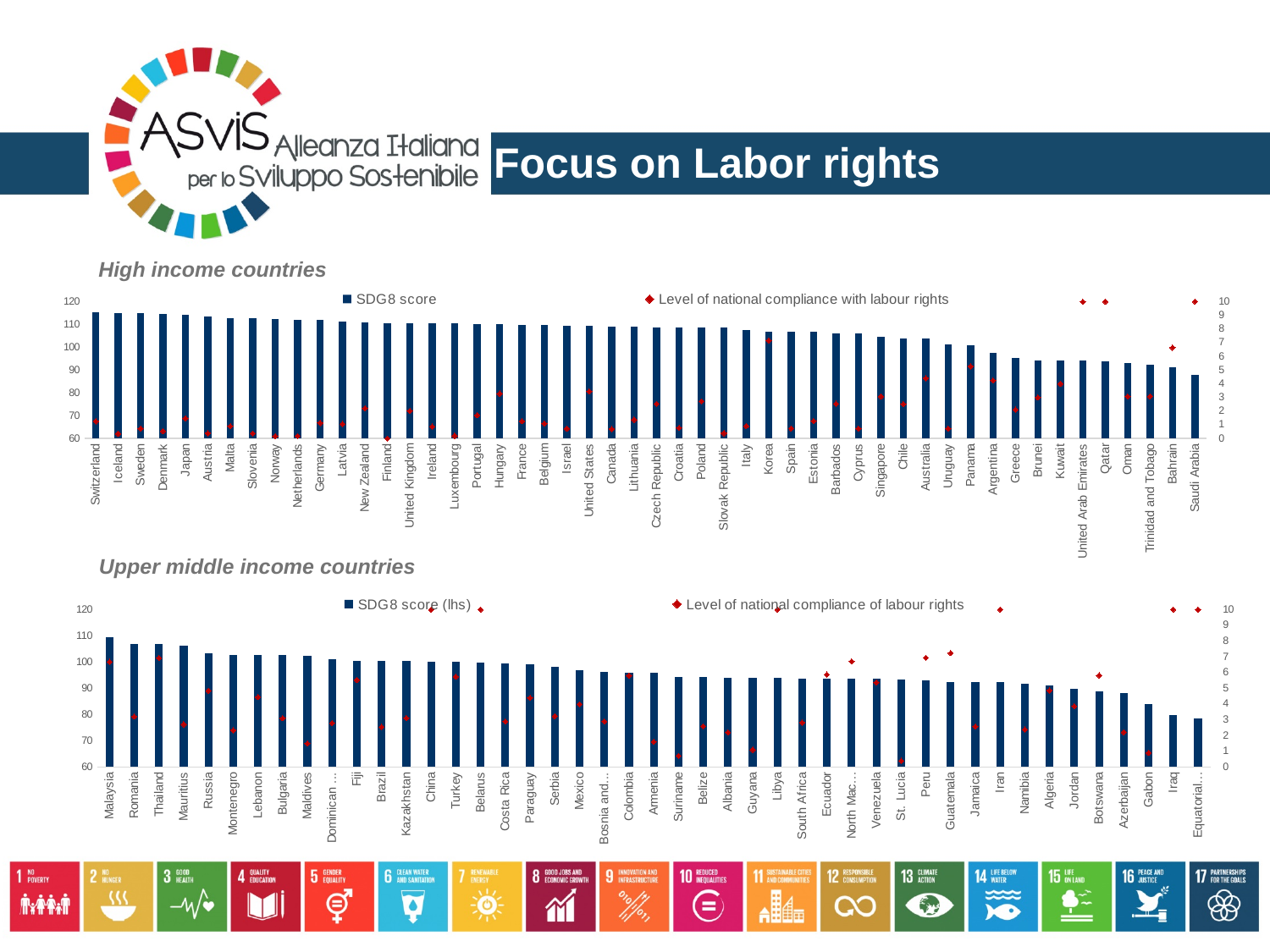
On the Upper middle income countries chart, which has the larger SDG8 score bar, Romania or Jordan? Romania What kind of chart is used for the SDG8 score on the High income countries chart? bar chart On the Upper middle income countries chart, is the SDG8 score for Malaysia greater or less than 100? greater On the High income countries chart, which country has the lowest SDG8 score bar? Saudi Arabia On the High income countries chart, which has the larger SDG8 score bar, Japan or Greece? Japan On the Upper middle income countries chart, which country has the highest SDG8 score bar? Malaysia On the High income countries chart, is the SDG8 score for Saudi Arabia greater or less than 90? less On the High income countries chart, which country has the highest SDG8 score bar? Switzerland On the Upper middle income countries chart, is the SDG8 score for Gabon greater or less than 90? less How many series does the legend of the High income countries chart list? 2 On the Upper middle income countries chart, do the SDG8 score bars rise or fall from left to right? fall